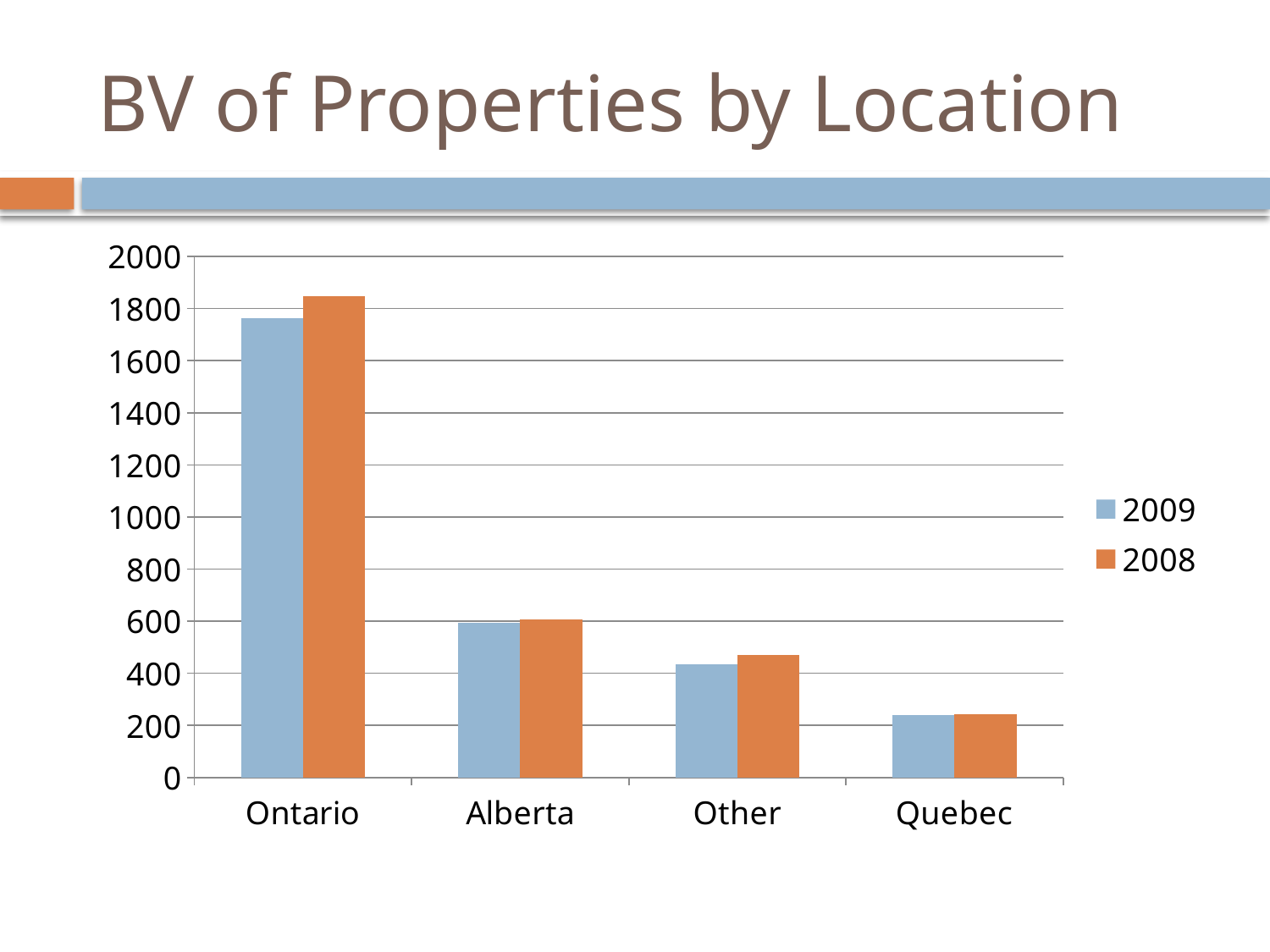
Which colour represents the 2008 series in the legend? orange Which location has the lowest book value in 2008? Quebec How many location categories are shown on the x axis? 4 Is the 2009 value for Ontario greater or less than 1600? greater For Other, which year has the larger value, 2008 or 2009? 2008 Is the 2008 value for Ontario greater or less than 1800? greater What type of chart is shown on the slide? bar chart Is the 2009 value for Alberta greater or less than 800? less For Ontario, which year has the larger value, 2008 or 2009? 2008 Which location has the highest book value in 2009? Ontario How many series does the legend list? 2